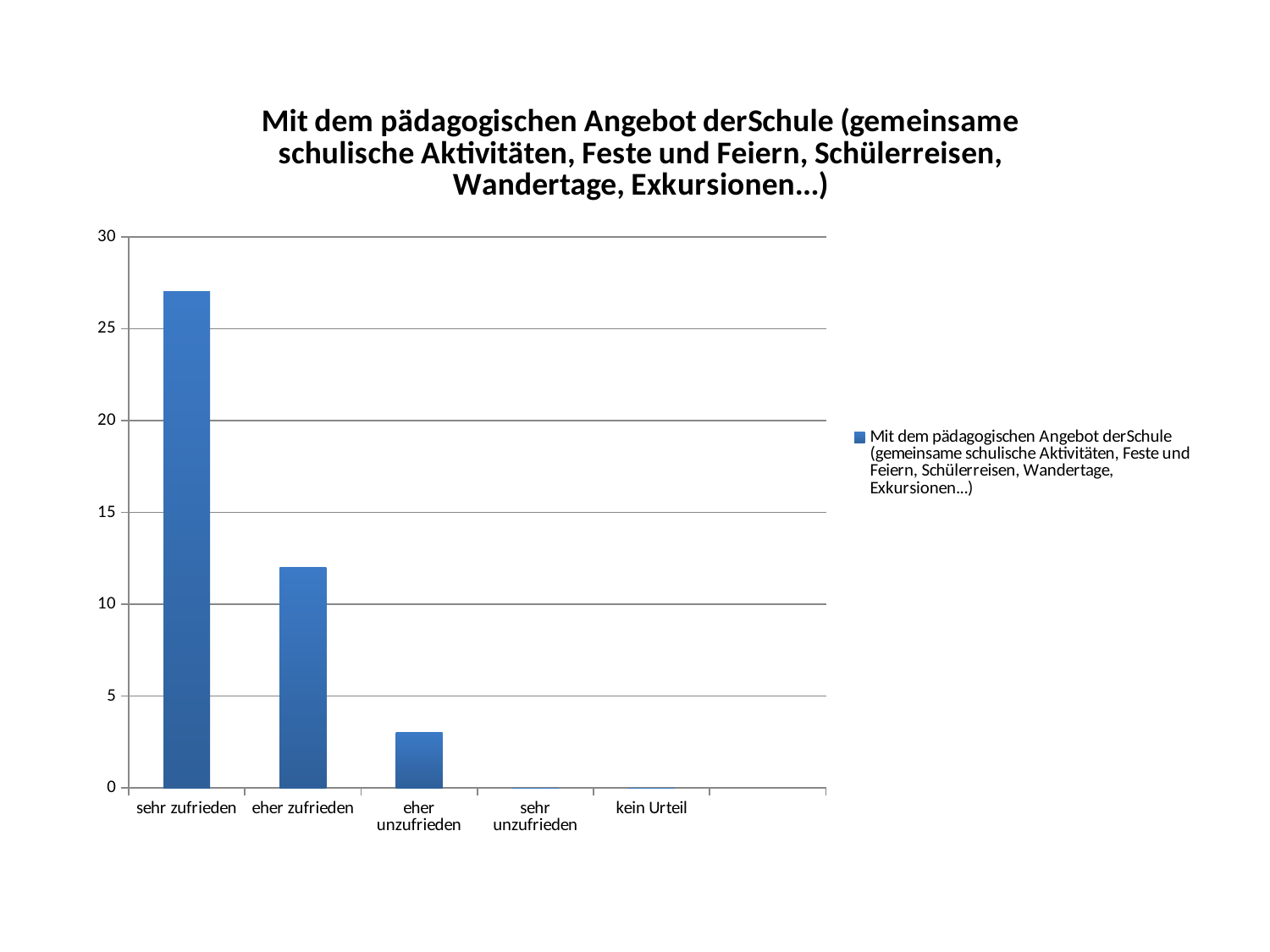
How many series does the legend list? 1 Which of the three categories with visible bars has the lowest value? eher unzufrieden Is the value for sehr zufrieden greater or less than 30? less Which is larger, the value for sehr zufrieden or the value for eher zufrieden? sehr zufrieden Is the value for eher unzufrieden greater or less than 5? less Is the value for eher zufrieden greater or less than 15? less What kind of chart is shown on the slide? bar chart Which category has the highest value? sehr zufrieden What colour are the bars in the chart? blue Do the bar values rise or fall from left to right along the x axis? fall